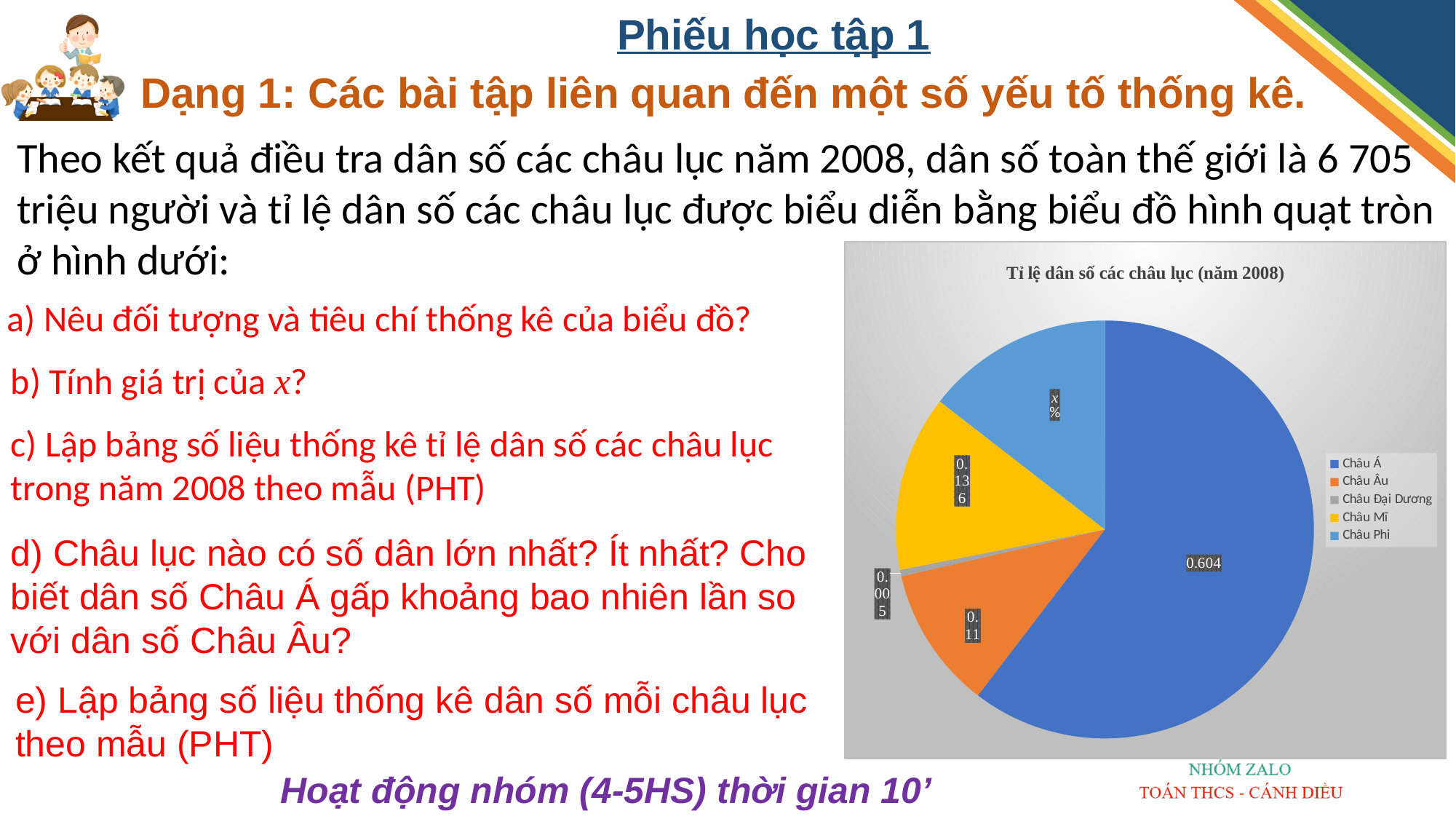
What value is shown for Châu Á in the pie chart? 0.604 Which continent has the largest slice in the pie chart? Châu Á What is the title of the chart? Tỉ lệ dân số các châu lục (năm 2008) How many continents are listed in the chart legend? 5 What is the difference between the values for Châu Á and Châu Âu? 0.494 Which continent has the smallest slice in the pie chart? Châu Đại Dương What label is printed on the Châu Phi slice of the pie chart? x% What value is shown for Châu Âu in the pie chart? 0.11 What value is shown for Châu Đại Dương in the pie chart? 0.005 Which slice is larger, Châu Mĩ or Châu Âu? Châu Mĩ What value is shown for Châu Mĩ in the pie chart? 0.136 What type of chart is shown on the slide? pie chart